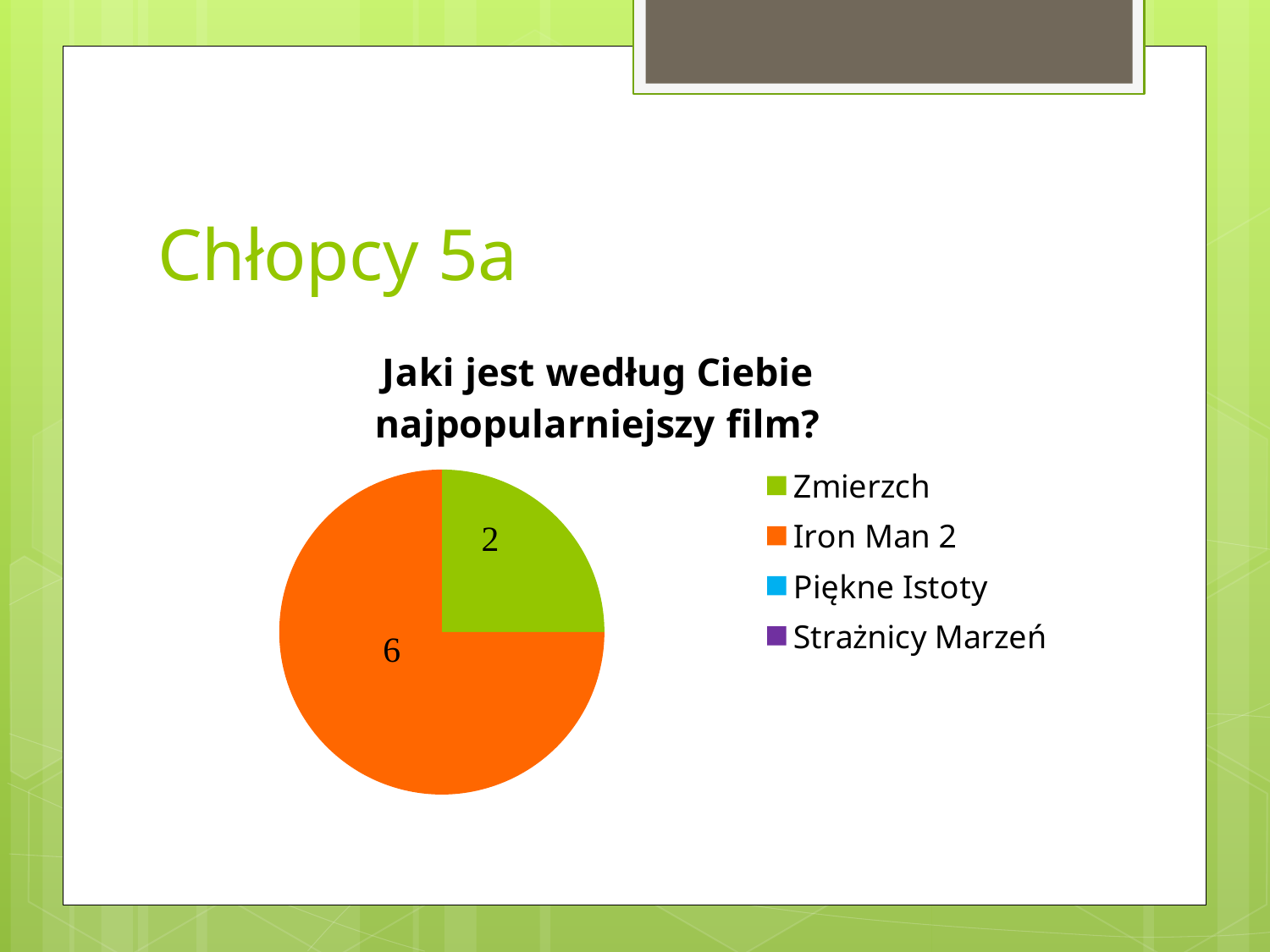
What colour represents Iron Man 2 in the pie chart? orange What kind of chart is shown on the slide? pie chart What is the difference between the values for Iron Man 2 and Zmierzch? 4 Which film has the largest slice in the pie chart? Iron Man 2 What value is shown for Iron Man 2 in the pie chart? 6 How many entries does the chart legend list? 4 What share of the pie does Zmierzch represent? 25% What value is shown for Zmierzch in the pie chart? 2 What share of the pie does Iron Man 2 represent? 75% How many slices with data labels are visible in the pie chart? 2 Which is larger, the value for Zmierzch or the value for Iron Man 2? Iron Man 2 What is the title of the chart? Jaki jest według Ciebie najpopularniejszy film?